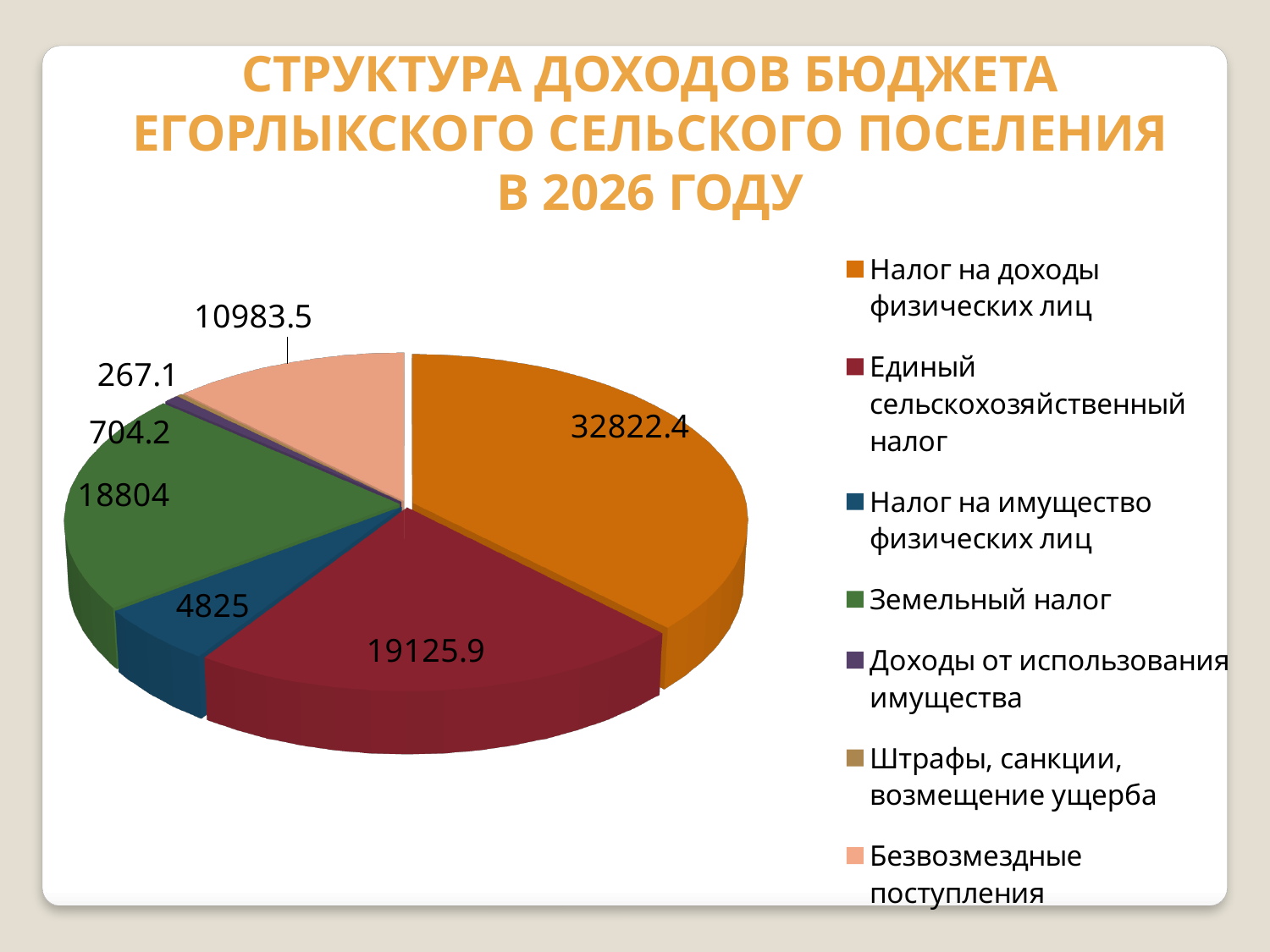
What is the value shown for Налог на доходы физических лиц? 32822.4 What is the value shown for Земельный налог? 18804 What is the difference between Земельный налог and Налог на имущество физических лиц? 13979 What is the value shown for Единый сельскохозяйственный налог? 19125.9 What colour is the slice for Земельный налог? Green Which is larger, Единый сельскохозяйственный налог or Земельный налог? Единый сельскохозяйственный налог What kind of chart is shown on the slide? Pie chart What is the difference between Налог на доходы физических лиц and Единый сельскохозяйственный налог? 13696.5 How many categories does the legend list? 7 Which category has the largest value in the pie chart? Налог на доходы физических лиц What is the value shown for Безвозмездные поступления? 10983.5 What is the value shown for Налог на имущество физических лиц? 4825